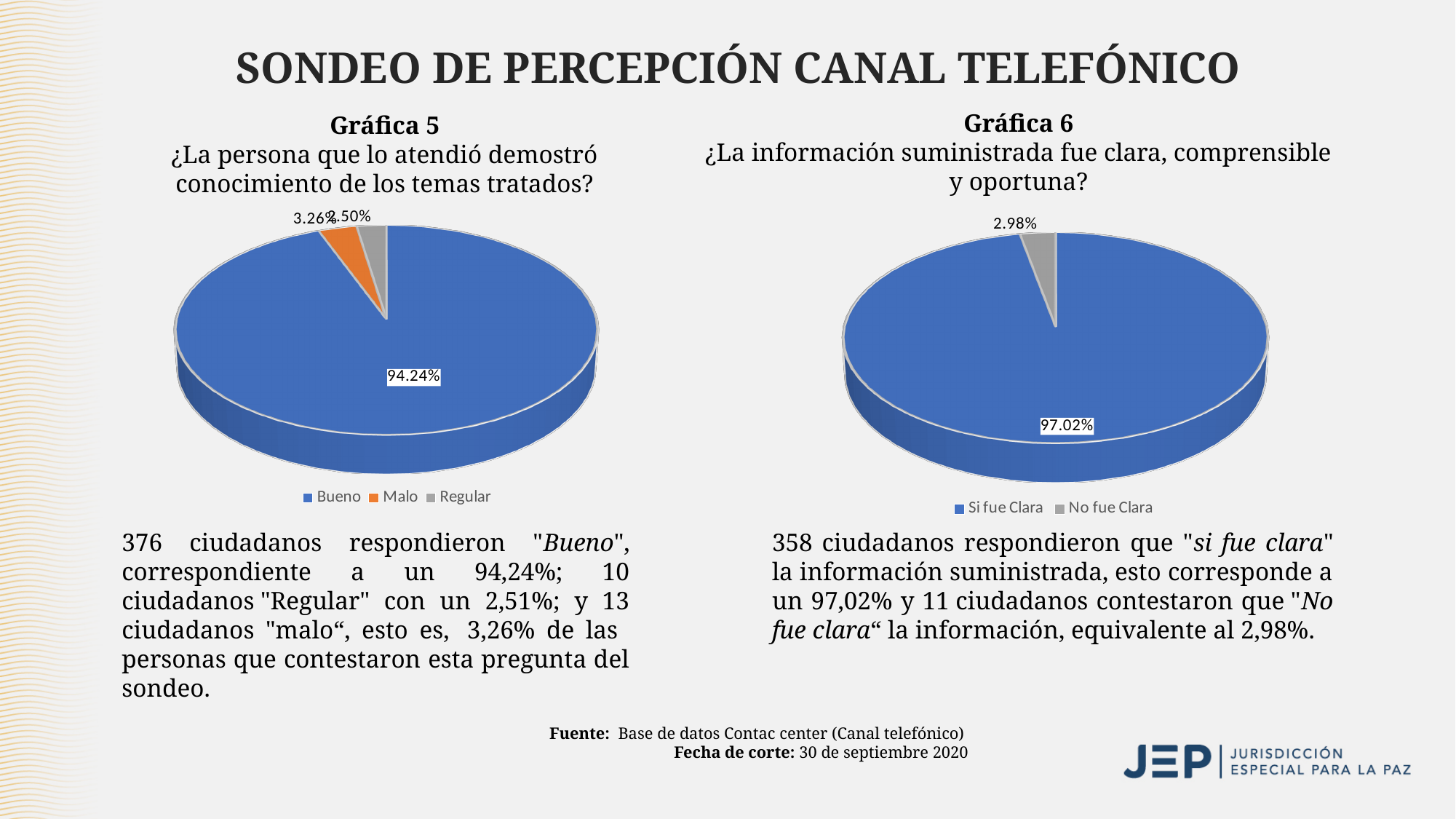
In Gráfica 5, how many categories does the legend list? 3 In Gráfica 6, how many categories does the legend list? 2 In Gráfica 5, what is the difference in percentage points between "Bueno" and "Malo"? 90.98 In Gráfica 6, what percentage of respondents answered "Si fue Clara"? 97.02% In Gráfica 5, which slice is larger, "Malo" or "Regular"? Malo What type of chart is Gráfica 6? Pie chart In Gráfica 6, what percentage is shown for "No fue Clara"? 2.98% In Gráfica 5, what percentage is shown for the "Malo" slice? 3.26% In Gráfica 5, what percentage of respondents answered "Bueno"? 94.24% In Gráfica 6, which category has the smallest share? No fue Clara In Gráfica 5, which category has the largest share? Bueno In Gráfica 5, what colour is the "Malo" slice? Orange